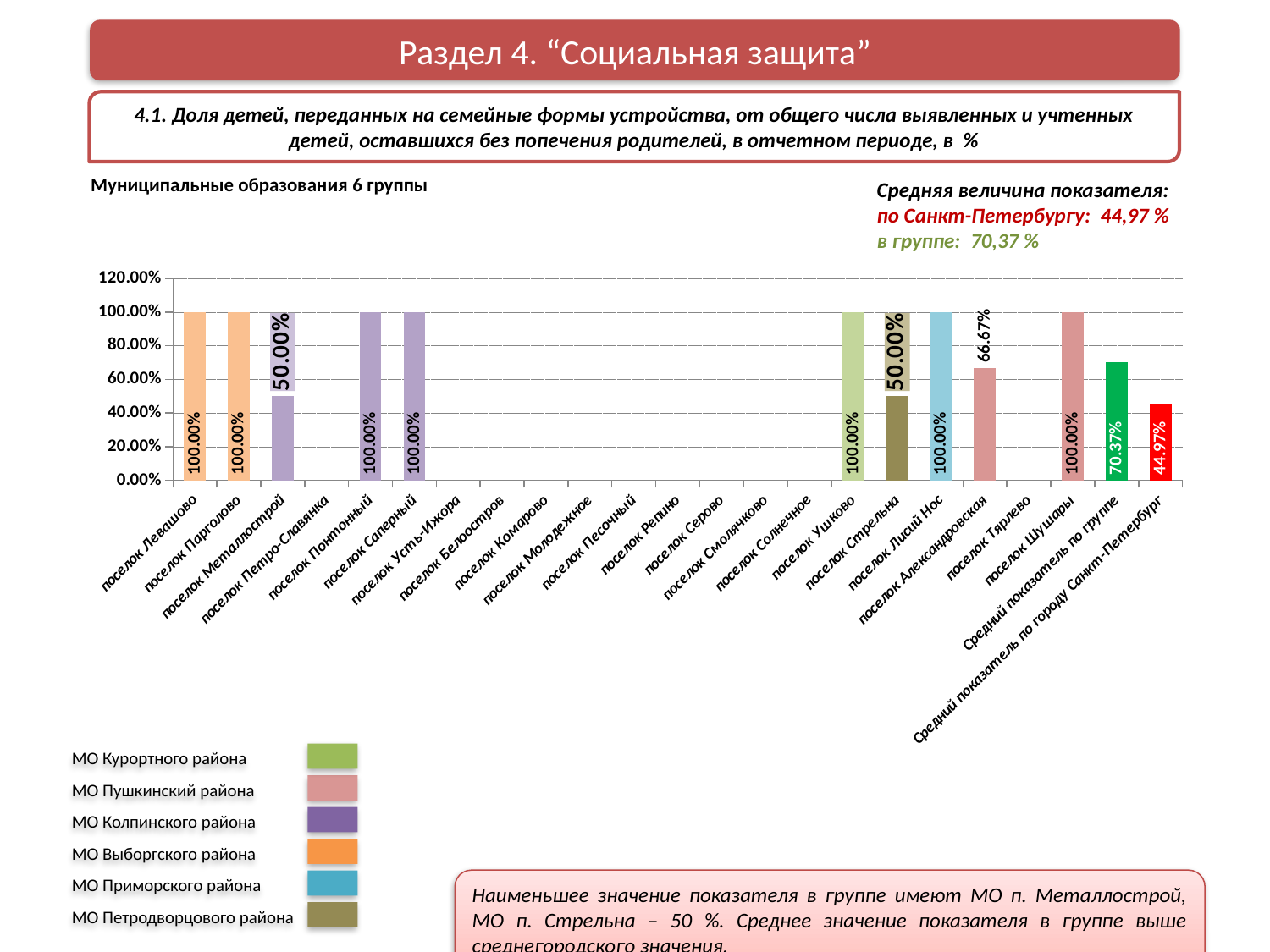
Which category has the lowest bar on the chart? Средний показатель по городу Санкт-Петербург What kind of chart is shown on the slide? bar chart What is the value for Средний показатель по городу Санкт-Петербург? 44.97% What is the value for Средний показатель по группе? 70.37% Which is larger, the value for поселок Стрельна or the value for поселок Александровская? поселок Александровская What is the difference between the values for поселок Шушары and поселок Александровская? 33.33% What is the value for поселок Лисий Нос? 100.00% How many categories are listed on the x axis of the chart? 23 Is the value for Средний показатель по группе greater or less than 80.00%? less What is the value for поселок Александровская? 66.67% What is the value for поселок Металлострой? 50.00% What is the difference between Средний показатель по группе and Средний показатель по городу Санкт-Петербург? 25.40%